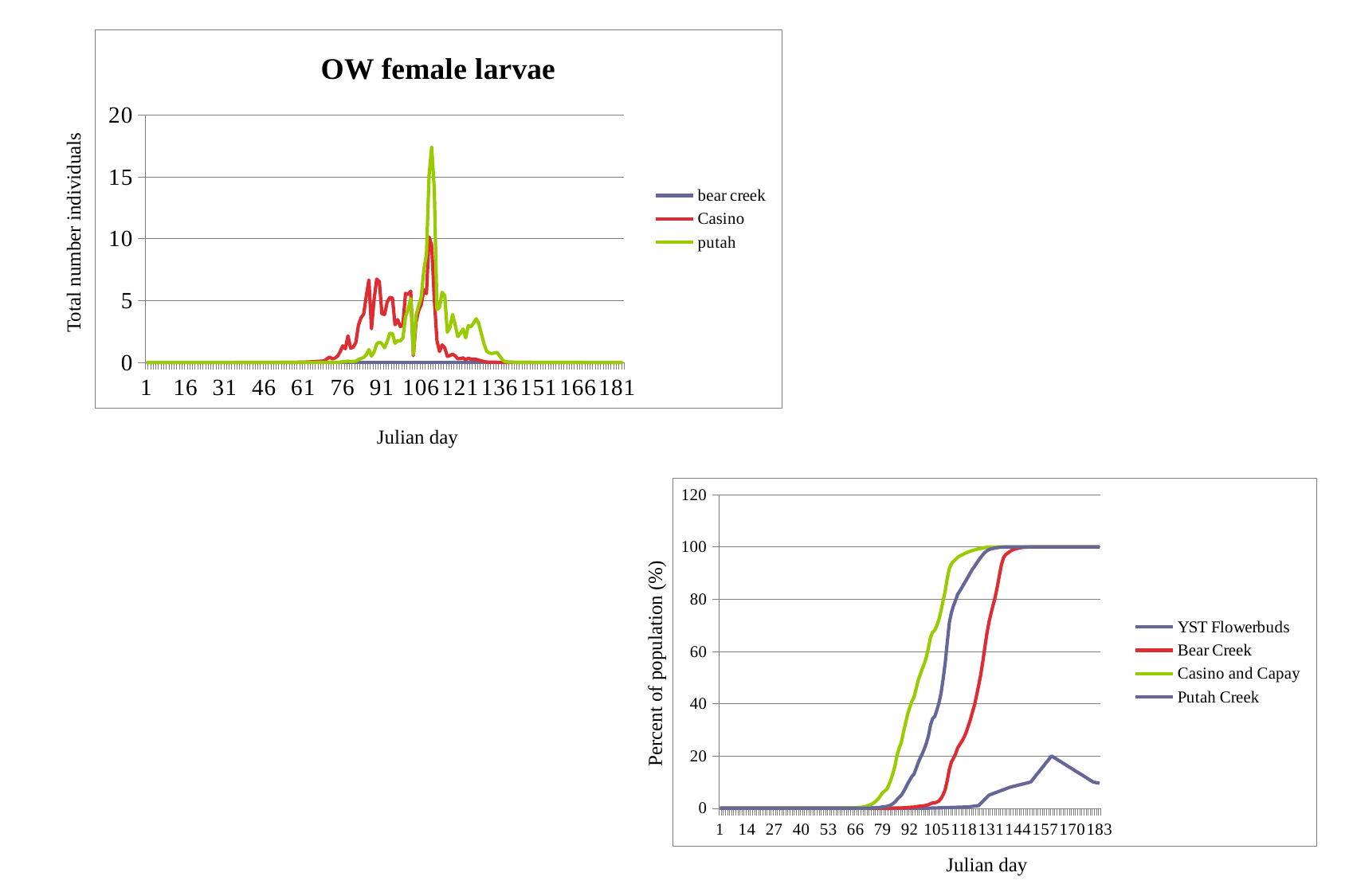
In the 'OW female larvae' chart, which series stays at 0 across all Julian days? bear creek How many series does the legend of the 'OW female larvae' chart list? 3 What is the y-axis label of the 'OW female larvae' chart? Total number individuals In the bottom-right chart, which series is the last to reach 100%? Bear Creek How many series does the legend of the bottom-right chart list? 4 What is the y-axis label of the bottom-right chart? Percent of population (%) In the 'OW female larvae' chart, which series reaches the highest peak? putah In the bottom-right chart, which series is the first to rise toward 100%? Casino and Capay What type of chart is the 'OW female larvae' chart? line chart In the bottom-right chart, is the peak value of YST Flowerbuds greater or less than 40? less In the 'OW female larvae' chart, is the peak value of the putah series greater or less than 15? greater What type of chart is the bottom-right chart? line chart